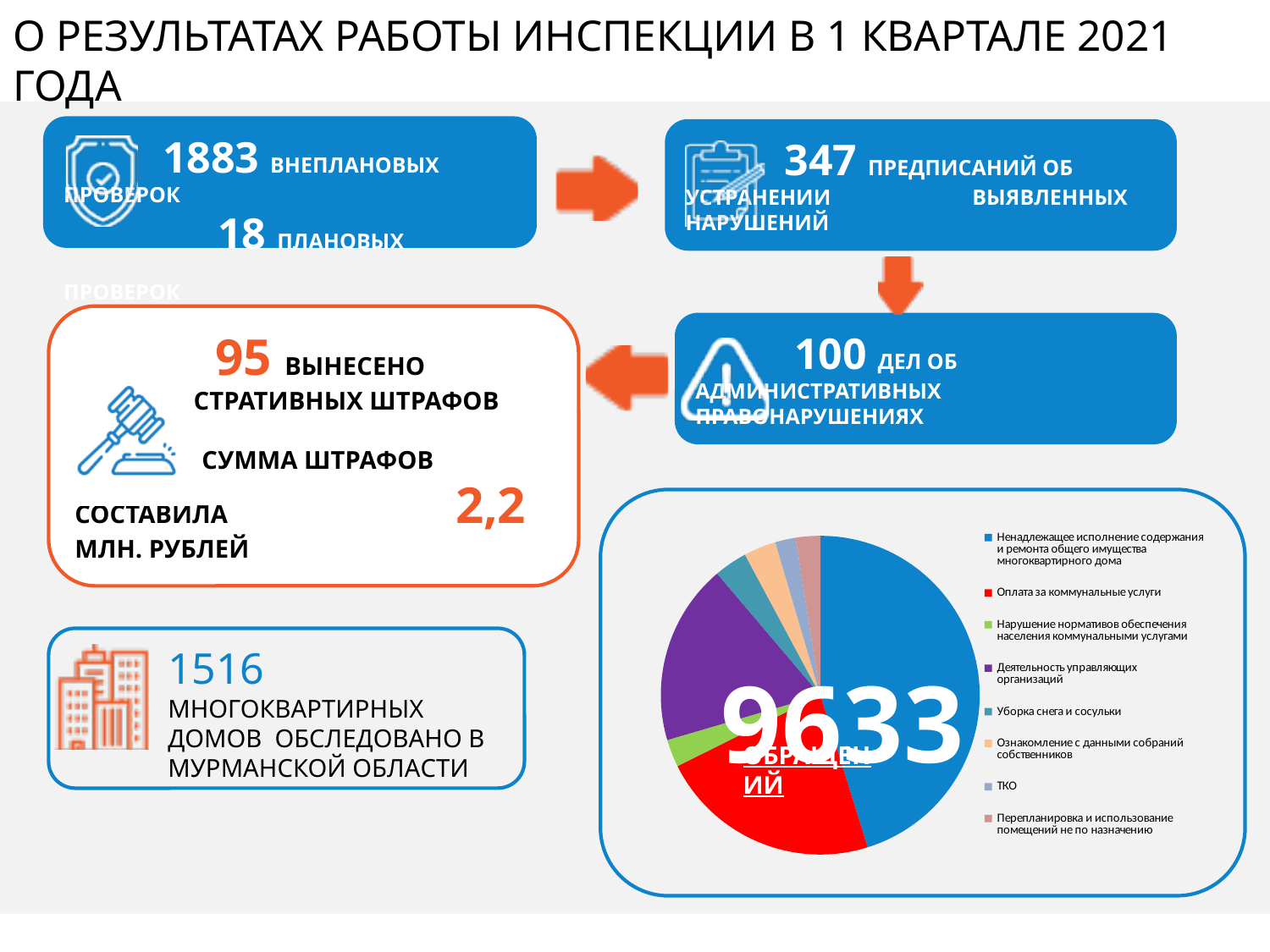
What colour represents "Оплата за коммунальные услуги" in the pie chart legend? red In the pie chart, which slice is larger: "Ненадлежащее исполнение содержания и ремонта общего имущества многоквартирного дома" or "Деятельность управляющих организаций"? Ненадлежащее исполнение содержания и ремонта общего имущества многоквартирного дома How many categories does the legend of the pie chart list? 8 Which category has the largest slice in the pie chart? Ненадлежащее исполнение содержания и ремонта общего имущества многоквартирного дома What number is printed in large white text over the pie chart? 9633 What kind of chart is shown in the bottom-right box of the slide? pie chart In the pie chart, which slice is larger: "Деятельность управляющих организаций" or "Уборка снега и сосульки"? Деятельность управляющих организаций In the pie chart, which slice is larger: "Оплата за коммунальные услуги" or "Нарушение нормативов обеспечения населения коммунальными услугами"? Оплата за коммунальные услуги